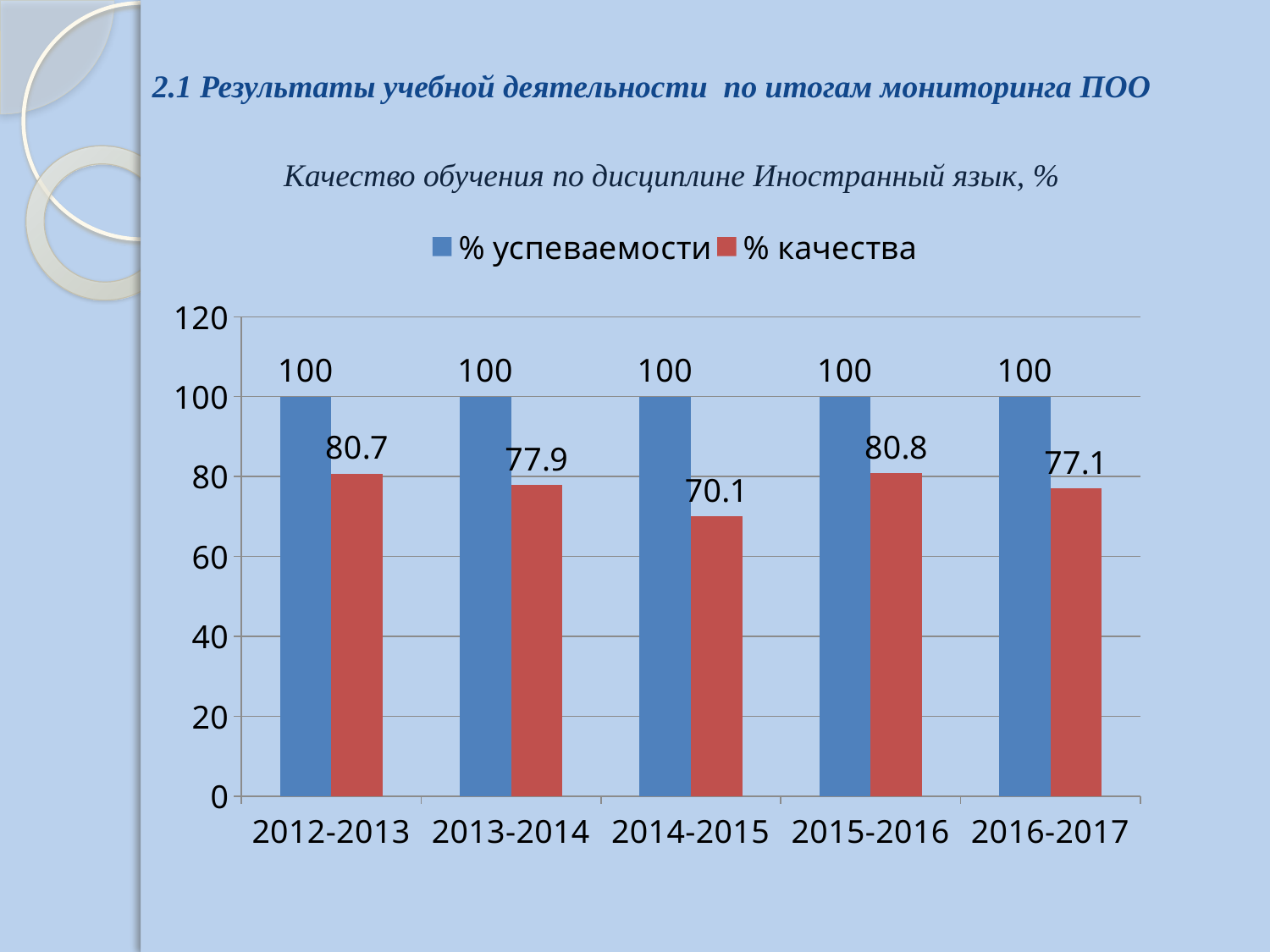
Which academic year has the lowest % качества? 2014-2015 What kind of chart is shown on the slide? Bar chart What is the value of % качества for 2015-2016? 80.8 Which academic year has the highest % качества? 2015-2016 How many series does the legend list? 2 Which colour represents % качества in the legend? Red What is the difference in % качества between 2012-2013 and 2013-2014? 2.8 What is the value of % качества for 2014-2015? 70.1 What is the difference between % успеваемости and % качества for 2016-2017? 22.9 Which is larger: % качества for 2013-2014 or for 2016-2017? 2013-2014 What is the value of % успеваемости for 2012-2013? 100 How many academic years are shown on the x axis? 5